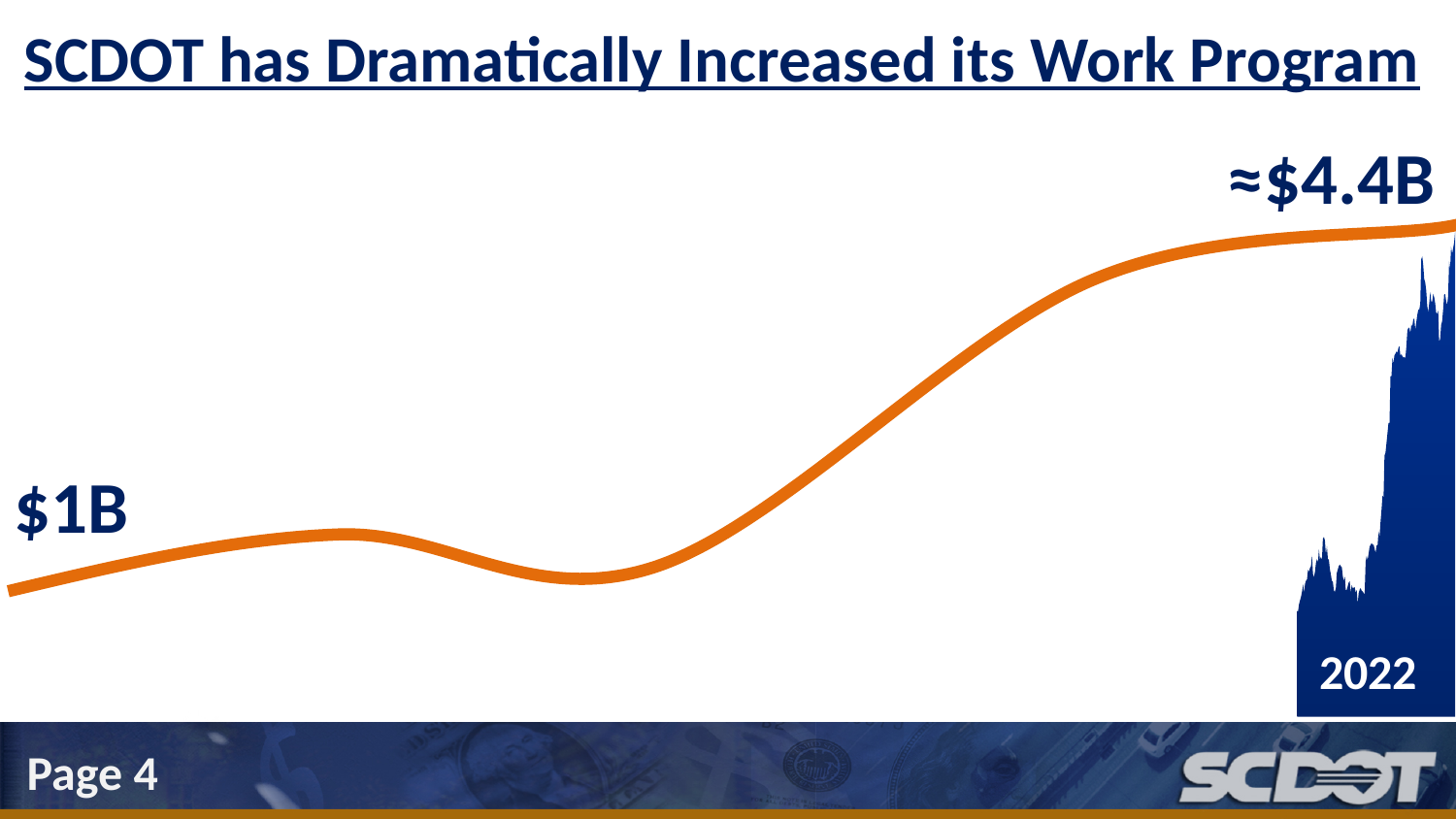
What colour is the plotted line? orange What is the title of the slide's chart? SCDOT has Dramatically Increased its Work Program Is the value at the end of the line greater or less than $4B? greater Does the line generally rise or fall from left to right? rise Which is larger, the value at the start of the line or the value in 2022? 2022 What value is labelled at the start of the line? $1B Which year is labelled at the right end of the chart? 2022 What kind of chart is shown on the slide? area chart How many lines are plotted on the chart? 1 What value is labelled at the end of the line, in 2022? ≈$4.4B